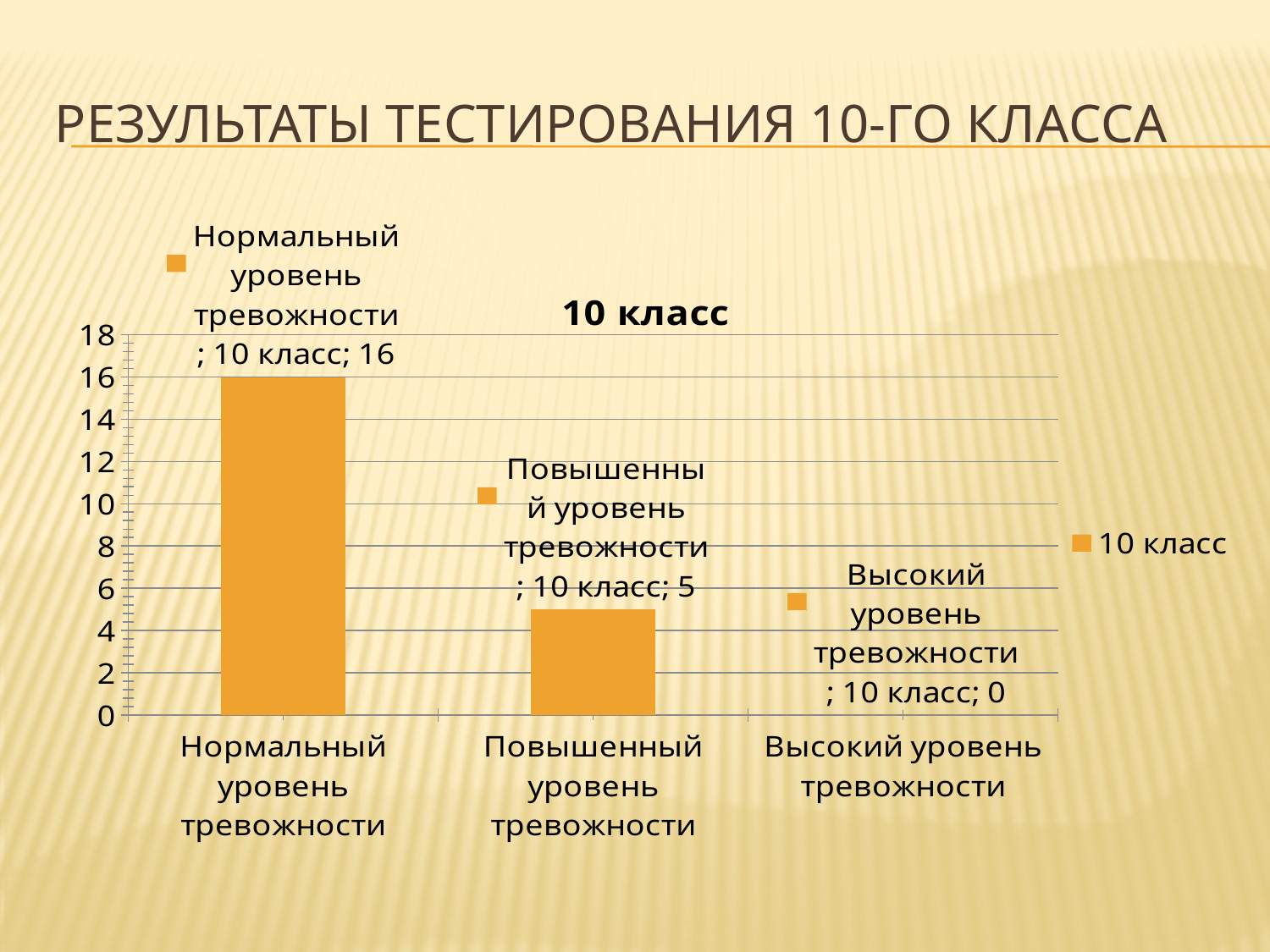
What is the value for Высокий уровень тревожности? 0 Which is larger: the value for Повышенный уровень тревожности or Высокий уровень тревожности? Повышенный уровень тревожности What kind of chart is shown? bar chart What is the value for Нормальный уровень тревожности? 16 Which category has the highest value? Нормальный уровень тревожности How many series does the legend list? 1 How many categories are shown on the x axis? 3 What is the difference between the values for Нормальный уровень тревожности and Повышенный уровень тревожности? 11 What is the title of the chart? 10 класс Is the value for Нормальный уровень тревожности greater or less than 10? greater Which category has the lowest value? Высокий уровень тревожности What is the value for Повышенный уровень тревожности? 5